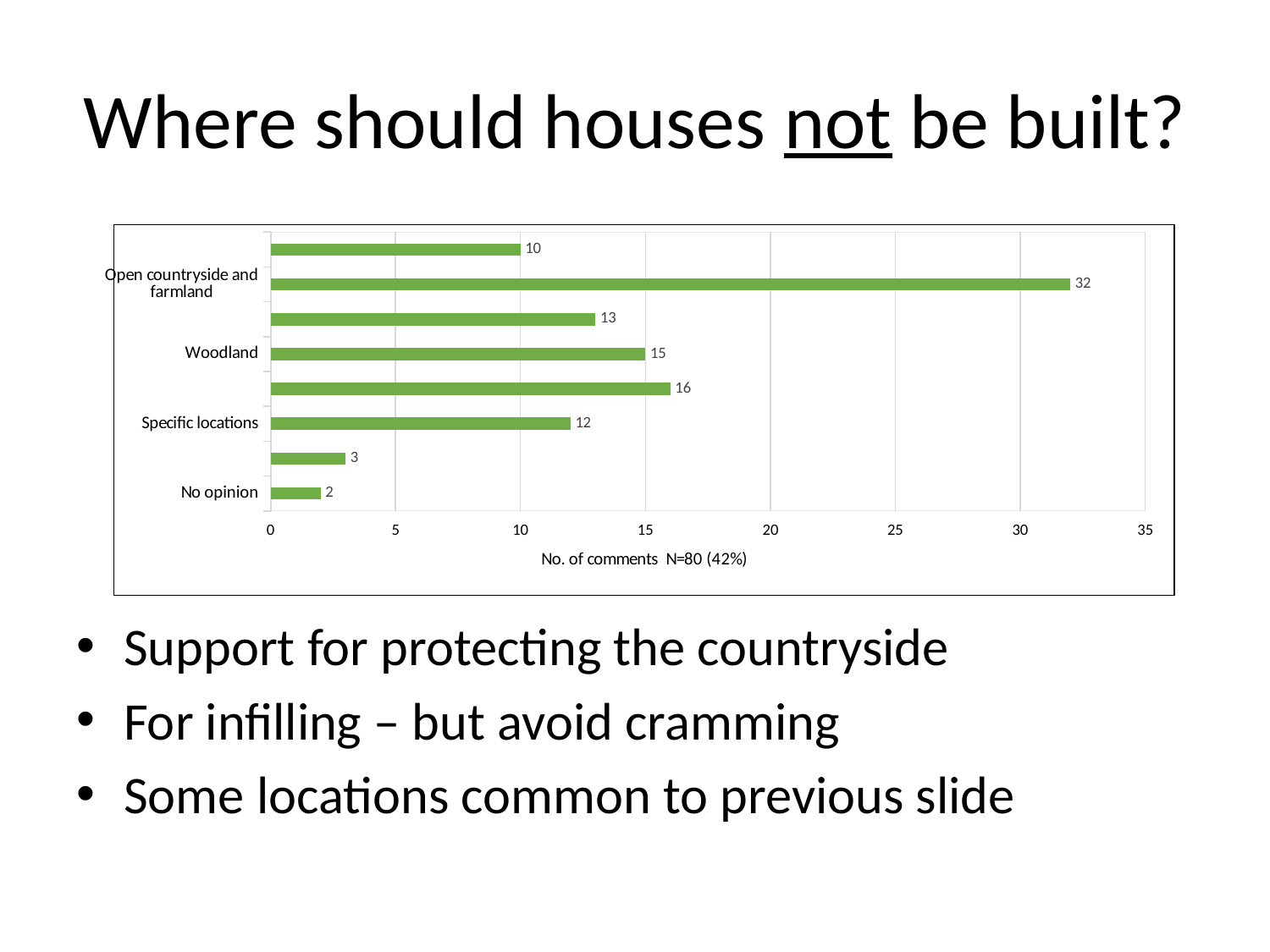
What is the value for No opinion? 2 What is the difference between the values for Woodland and Specific locations? 3 What is the value for Specific locations? 12 Is the value for Open countryside and farmland greater or less than 30? greater How many comments are recorded for Open countryside and farmland? 32 Which category has the highest number of comments? Open countryside and farmland What is the value for Woodland? 15 What kind of chart is shown on the slide? bar chart Which labelled category has the lowest number of comments? No opinion How many bars are plotted in the chart? 8 Which has more comments, Woodland or Specific locations? Woodland What is the title of the horizontal axis? No. of comments N=80 (42%)